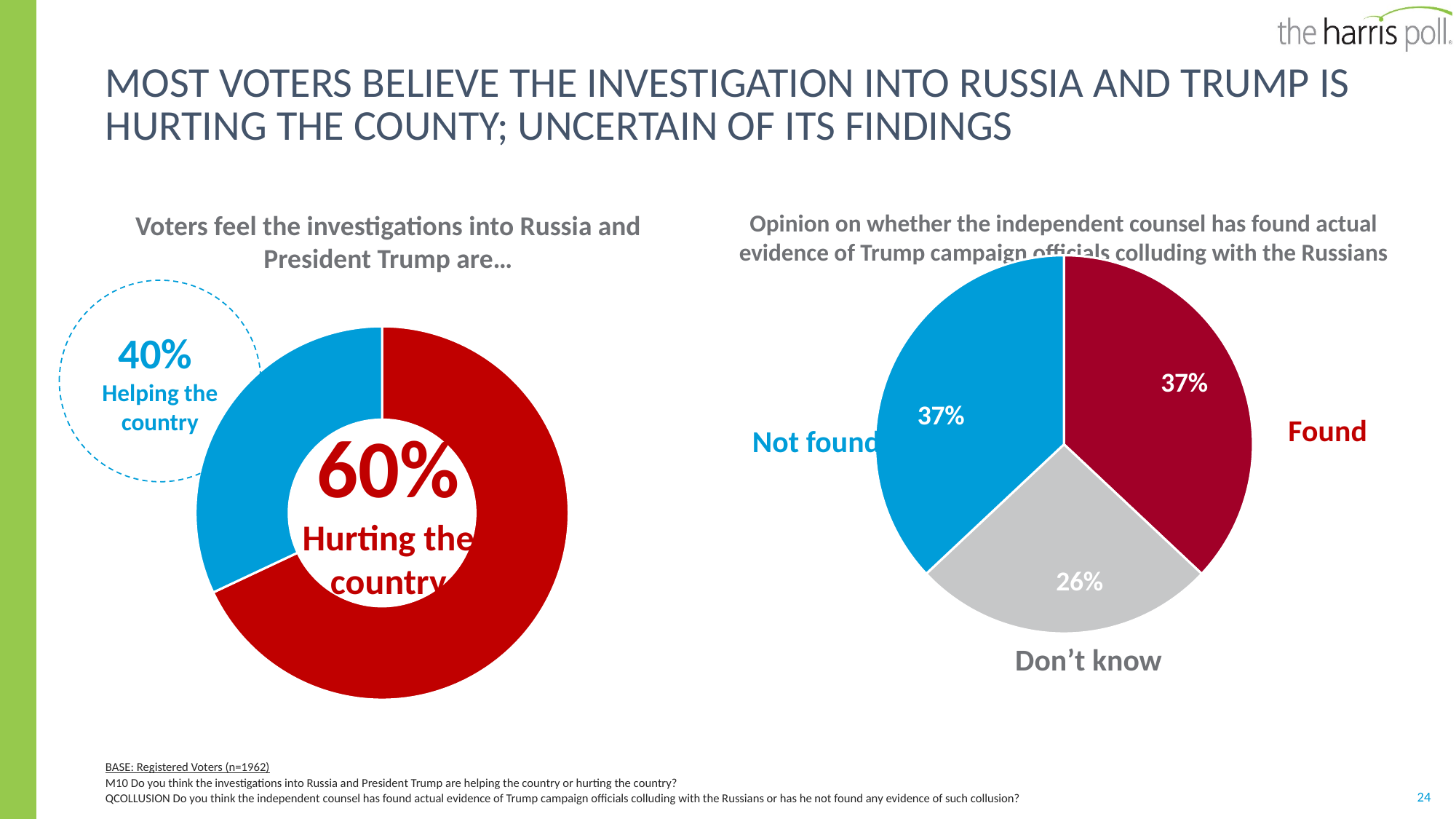
In the right chart ("Opinion on whether the independent counsel has found actual evidence..."), what percentage answered "Don't know"? 26% What kind of chart is the left chart ("Voters feel the investigations into Russia and President Trump are...")? Doughnut chart In the left chart ("Voters feel the investigations into Russia and President Trump are..."), what is the difference in percentage points between hurting the country and helping the country? 20 percentage points In the right chart ("Opinion on whether the independent counsel has found actual evidence..."), what percentage say the counsel has not found evidence? 37% In the right chart ("Opinion on whether the independent counsel has found actual evidence..."), which response has the smallest share? Don't know What kind of chart is the right chart ("Opinion on whether the independent counsel has found actual evidence...")? Pie chart In the left chart ("Voters feel the investigations into Russia and President Trump are..."), what percentage of voters say the investigations are helping the country? 40% In the right chart ("Opinion on whether the independent counsel has found actual evidence..."), what percentage say the counsel has found evidence? 37% In the left chart ("Voters feel the investigations into Russia and President Trump are..."), which response has the larger share: helping the country or hurting the country? Hurting the country How many slices does the right chart ("Opinion on whether the independent counsel has found actual evidence...") have? 3 In the right chart ("Opinion on whether the independent counsel has found actual evidence..."), what colour is the "Found" slice? Dark red In the left chart ("Voters feel the investigations into Russia and President Trump are..."), what percentage of voters say the investigations are hurting the country? 60%